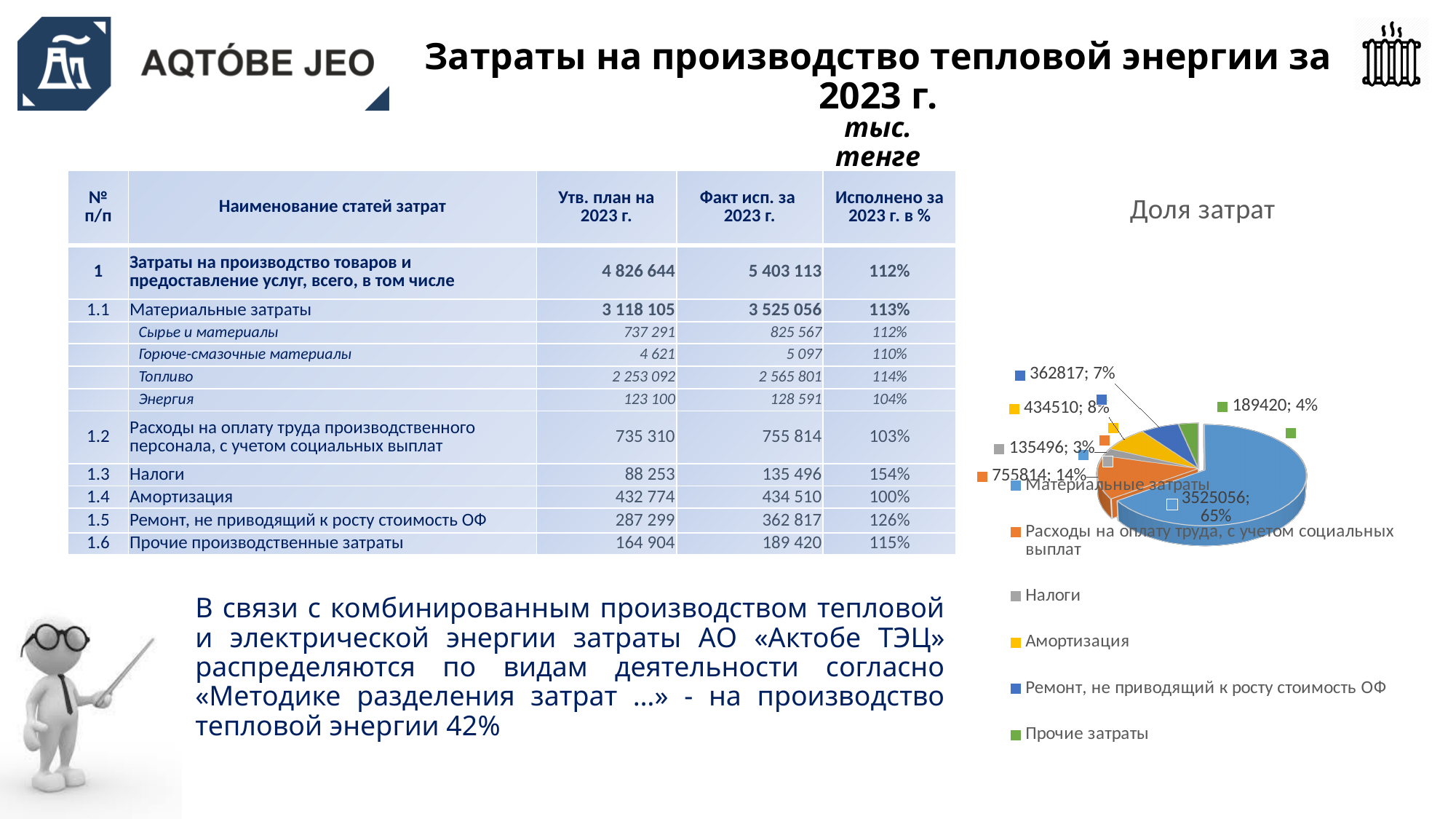
Which category has the smallest slice in the "Доля затрат" pie chart? Налоги What kind of chart is shown under the title "Доля затрат"? pie chart Which category has the largest slice in the "Доля затрат" pie chart? Материальные затраты How many slices does the "Доля затрат" pie chart have? 6 In the "Доля затрат" pie chart, what share does Материальные затраты have? 65% In the "Доля затрат" pie chart, what share does Прочие затраты have? 4% In the "Доля затрат" pie chart, what share does Расходы на оплату труда, с учетом социальных выплат have? 14% In the "Доля затрат" pie chart, what is the difference between the values for Амортизация and Ремонт, не приводящий к росту стоимость ОФ? 71693 In the "Доля затрат" pie chart, which is larger: Амортизация or Ремонт, не приводящий к росту стоимость ОФ? Амортизация In the "Доля затрат" pie chart, what value is shown for Налоги? 135496 In the "Доля затрат" pie chart, what value is shown for Амортизация? 434510 In the "Доля затрат" pie chart, what value is shown for Материальные затраты? 3525056